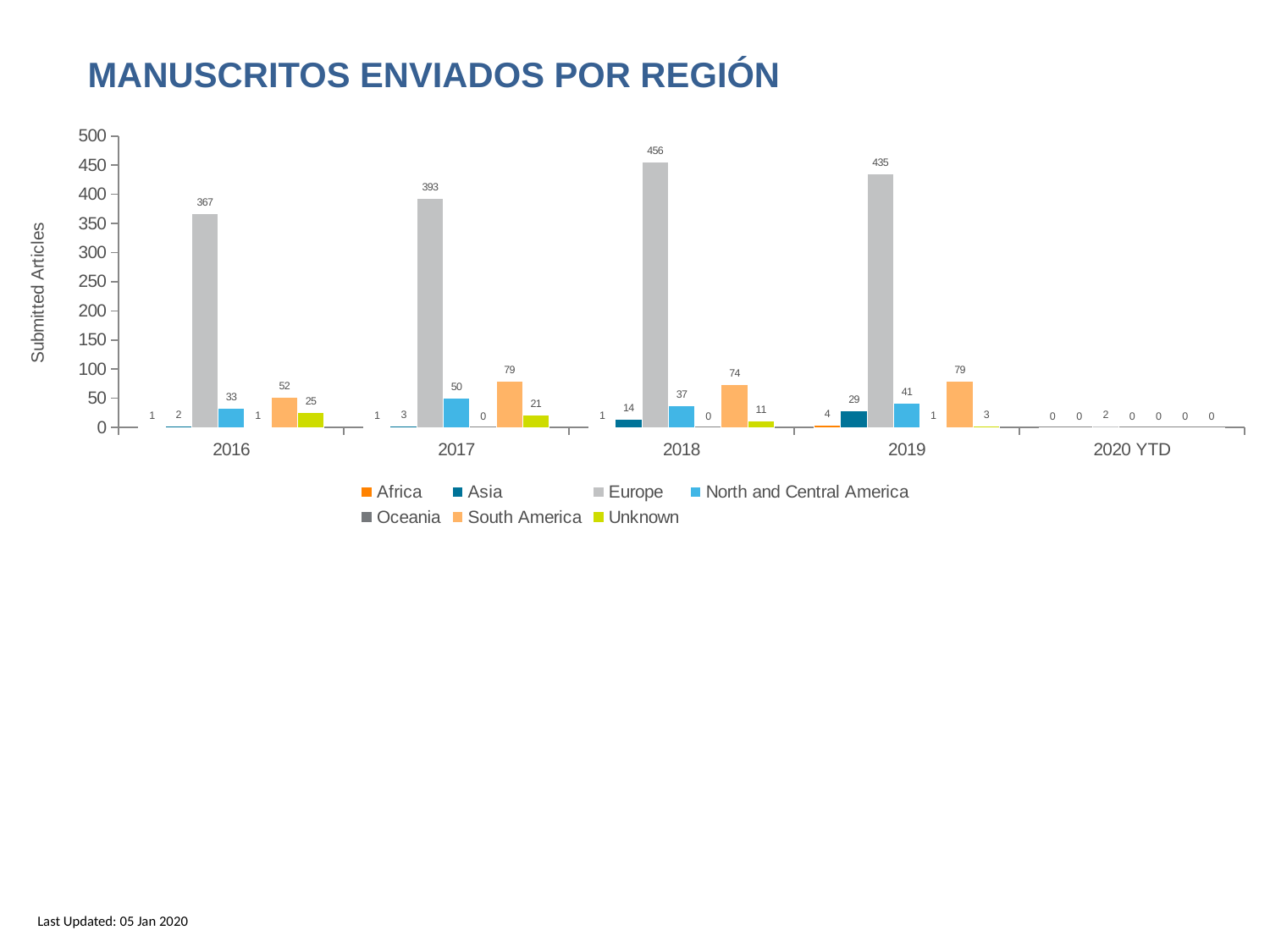
In which year is the Europe value highest? 2018 What is the value for Asia in 2019? 29 What is the difference between the Europe values for 2019 and 2016? 68 What is the value for South America in 2017? 79 Is the value for Europe in 2017 greater or less than 350? greater What is the value for Europe in 2018? 456 Which is larger, the South America value in 2018 or the North and Central America value in 2018? South America What is the value for North and Central America in 2016? 33 How many series does the legend list? 7 What kind of chart is shown on the slide? bar chart In which year is the Unknown value lowest? 2020 YTD How many year categories are shown on the x axis? 5